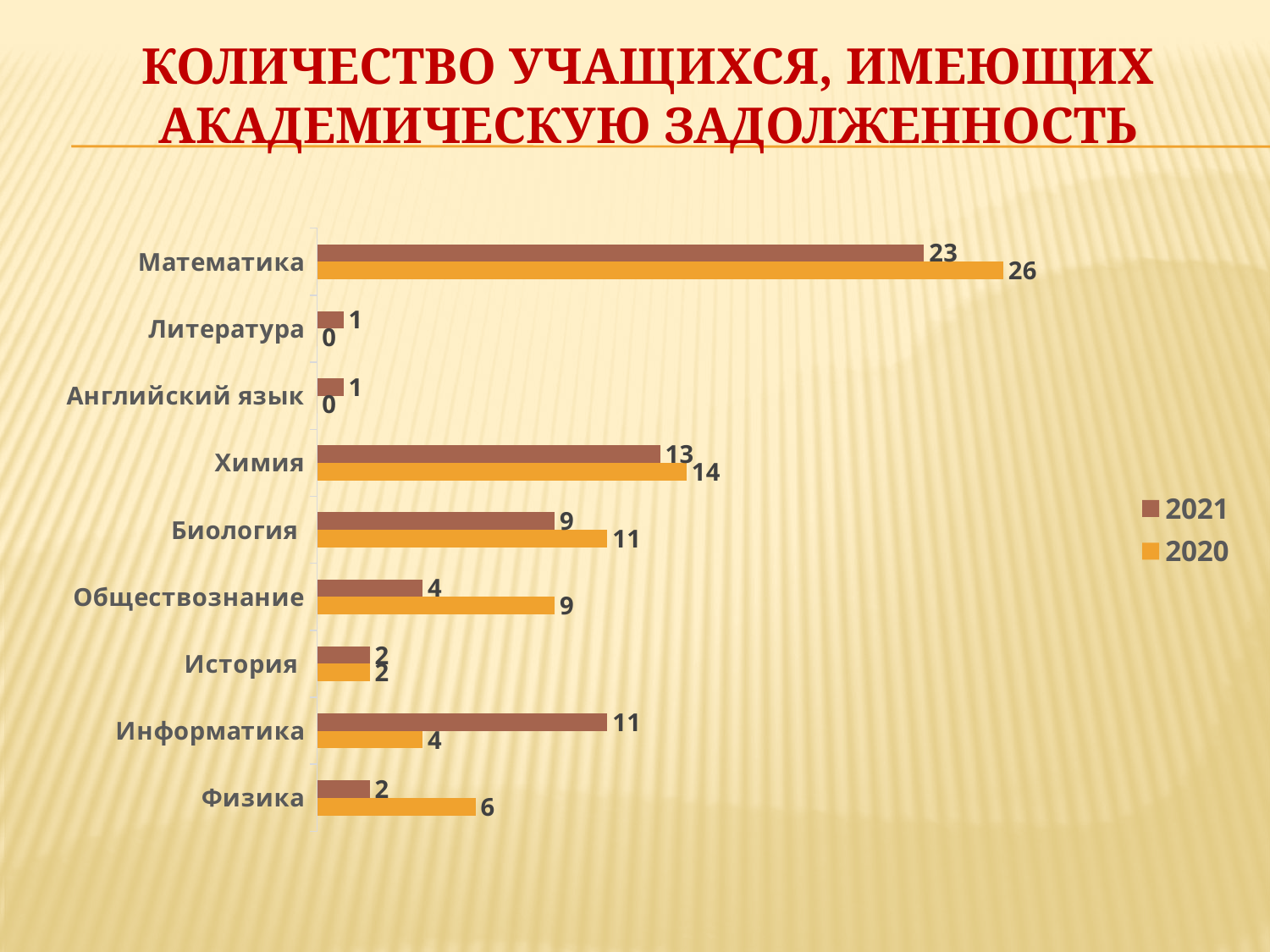
Which category has the highest value in the 2021 series? Математика What is the value for Математика in the 2020 series? 26 What is the value for Обществознание in the 2020 series? 9 What is the difference between the 2021 and 2020 values for Информатика? 7 Which category has the lowest value in the 2020 series? Литература and Английский язык (both 0) What is the difference between the 2020 and 2021 values for Химия? 1 What kind of chart is shown on the slide? Bar chart How many categories are shown on the chart? 9 Which series is shown in orange according to the legend? 2020 How many series does the legend list? 2 Which is larger for Физика: the 2021 value or the 2020 value? 2020 What is the value for Информатика in the 2021 series? 11